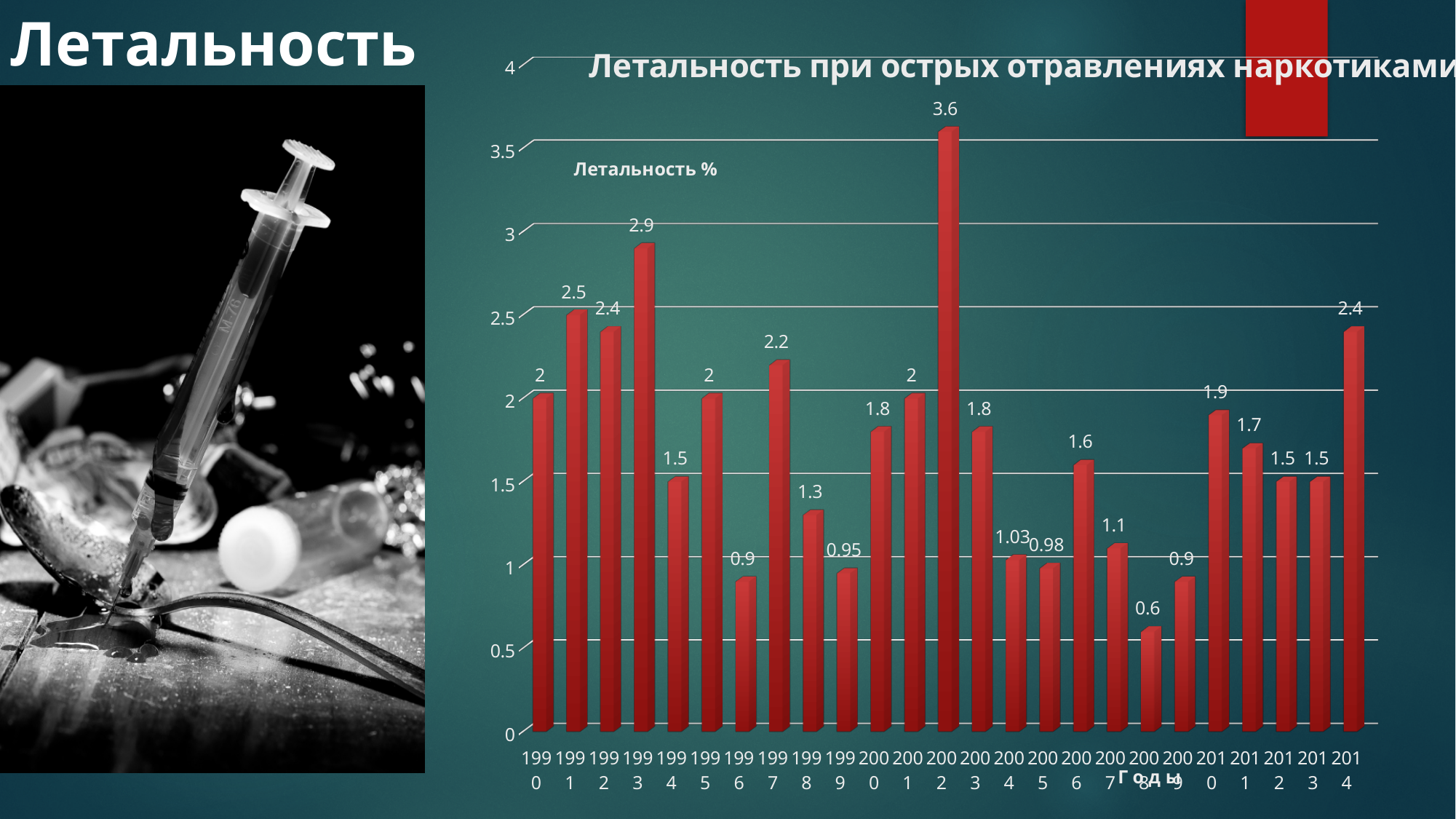
Which year has the highest lethality value? 2002 Which year has the lowest lethality value? 2008 What kind of chart is shown on the slide? Bar chart Which year has a higher lethality value, 1997 or 2006? 1997 What is the difference between the lethality values for 2002 and 1993? 0.7 What is the lethality value for 2014? 2.4 How many years are shown on the x axis? 25 What is the lethality value for 1993? 2.9 What is the lethality value for 2002? 3.6 What is the label of the x axis? Годы What is the lethality value for 2004? 1.03 What is the title of the chart? Летальность при острых отравлениях наркотиками